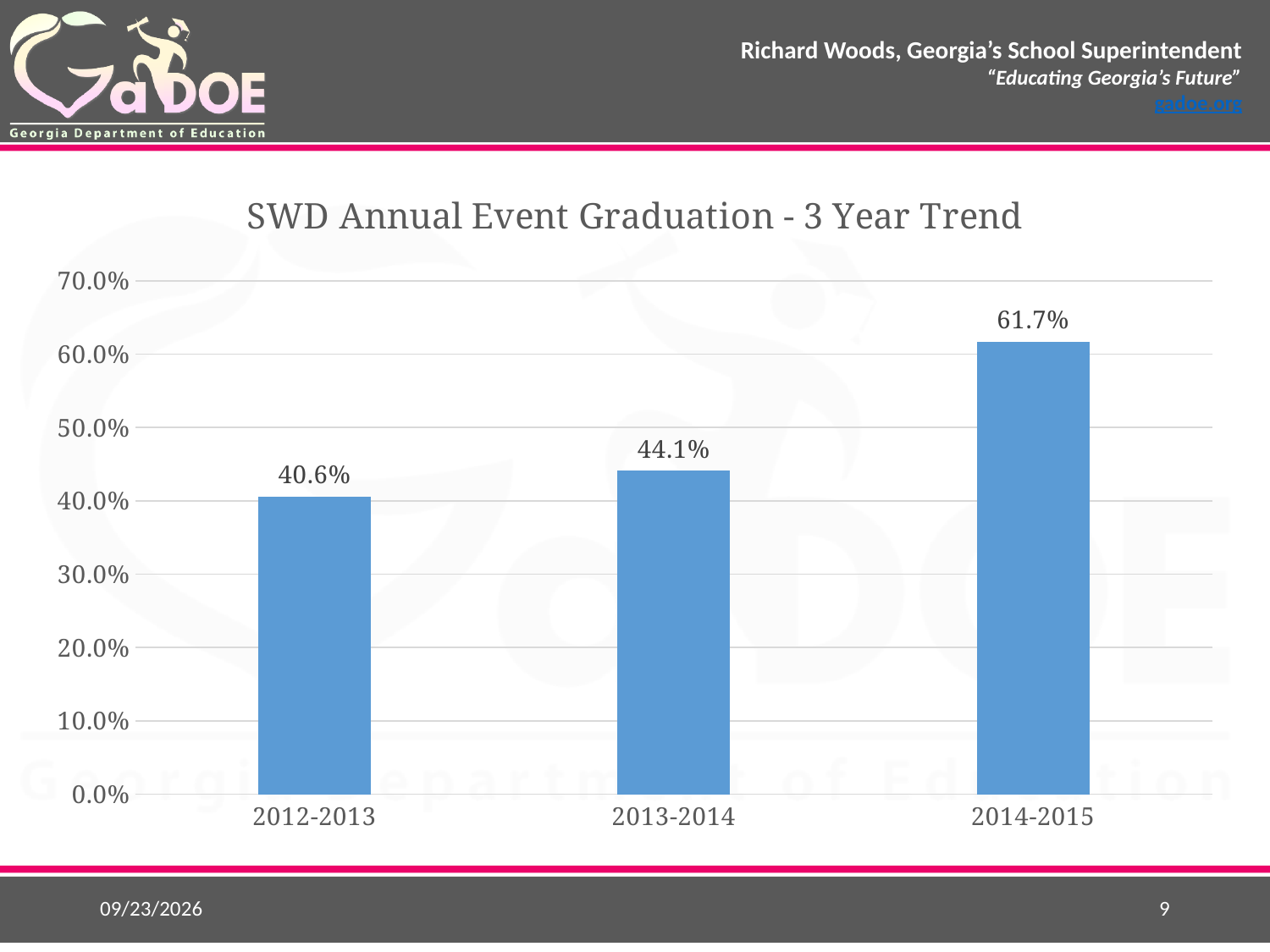
What is the value for 2013-2014? 44.1% What is the difference between the values for 2014-2015 and 2013-2014? 17.6% Which is larger, the value for 2012-2013 or the value for 2014-2015? 2014-2015 How many years are shown on the x axis? 3 Is the value for 2014-2015 greater or less than 60.0%? greater What is the value for 2012-2013? 40.6% Do the values rise or fall from 2012-2013 to 2014-2015? rise What is the value for 2014-2015? 61.7% What kind of chart is this? bar chart Which year has the lowest value? 2012-2013 Which year has the highest value? 2014-2015 What is the difference between the values for 2013-2014 and 2012-2013? 3.5%